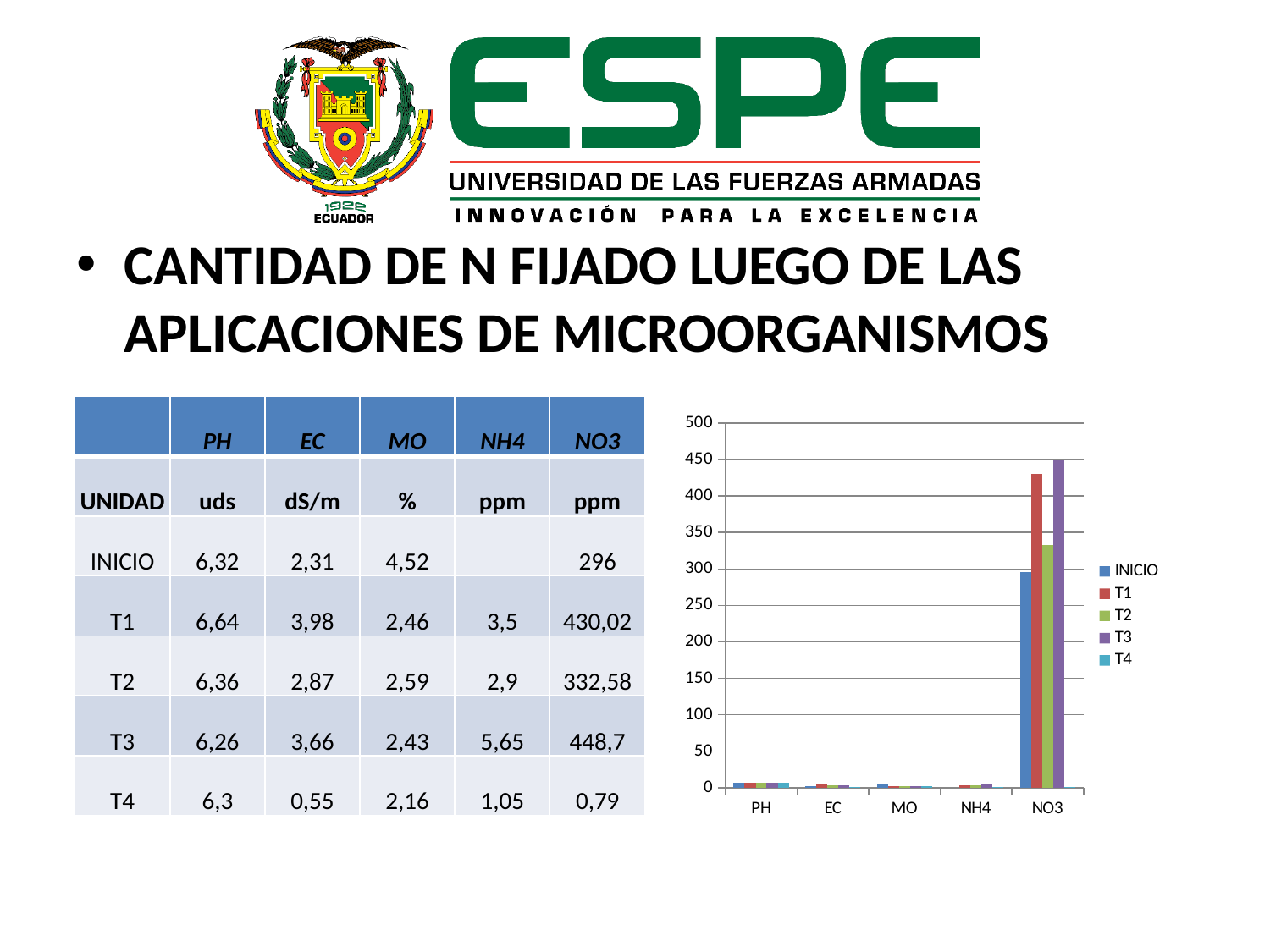
Is the value of the T2 bar for NO3 greater or less than 350? less Is the value of the T3 bar for NO3 greater or less than 400? greater Is the value of the INICIO bar for NO3 greater or less than 250? greater For NO3, which bar is taller: T3 or INICIO? T3 What colour represents the INICIO series in the chart legend? blue According to the table on the slide, what is the NO3 value for T3? 448,7 How many series does the chart legend list? 5 What kind of chart is shown on the slide? bar chart Using the values in the table, what is the difference between the NO3 value for T1 and the NO3 value for INICIO? 134,02 Which category on the x axis has the tallest bars in the chart? NO3 How many categories are shown on the x axis of the chart? 5 For NO3, which bar is taller: T1 or T2? T1